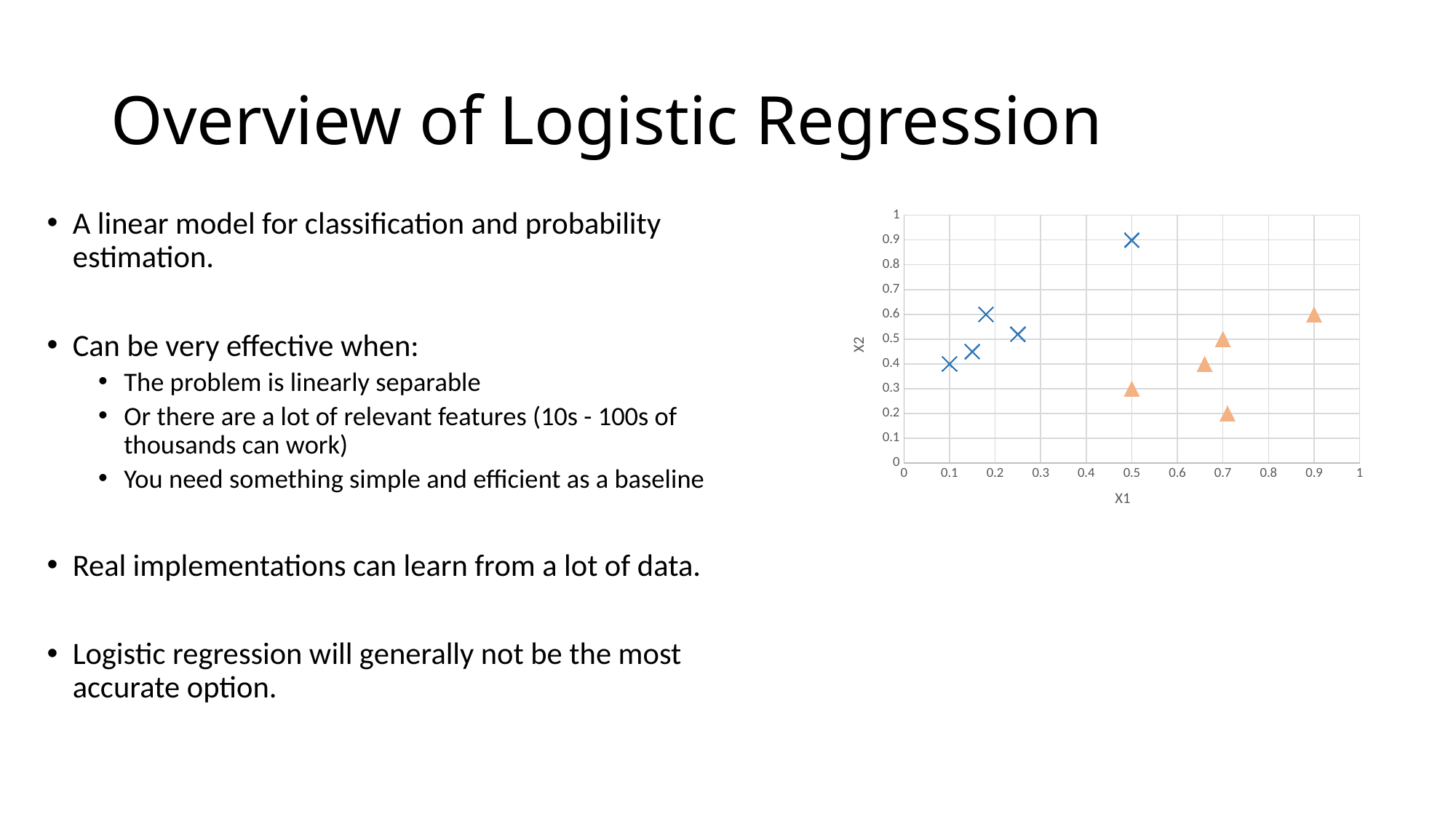
What kind of chart is shown on the slide? scatter chart How many distinct marker types (series) are plotted on the chart? 2 What is the label on the vertical axis of the chart? X2 What is the label on the horizontal axis of the chart? X1 How many blue X markers are plotted on the chart? 5 How many orange triangles have an X1 value greater than 0.6? 4 How many orange triangle markers are plotted on the chart? 5 Is the X2 value of the highest blue X point greater or less than 0.8? greater Is the X2 value of the lowest orange triangle greater or less than 0.3? less Which marker type has the point with the highest X2 value, the blue X or the orange triangle? blue X Is the X1 value of the rightmost orange triangle greater or less than 0.8? greater